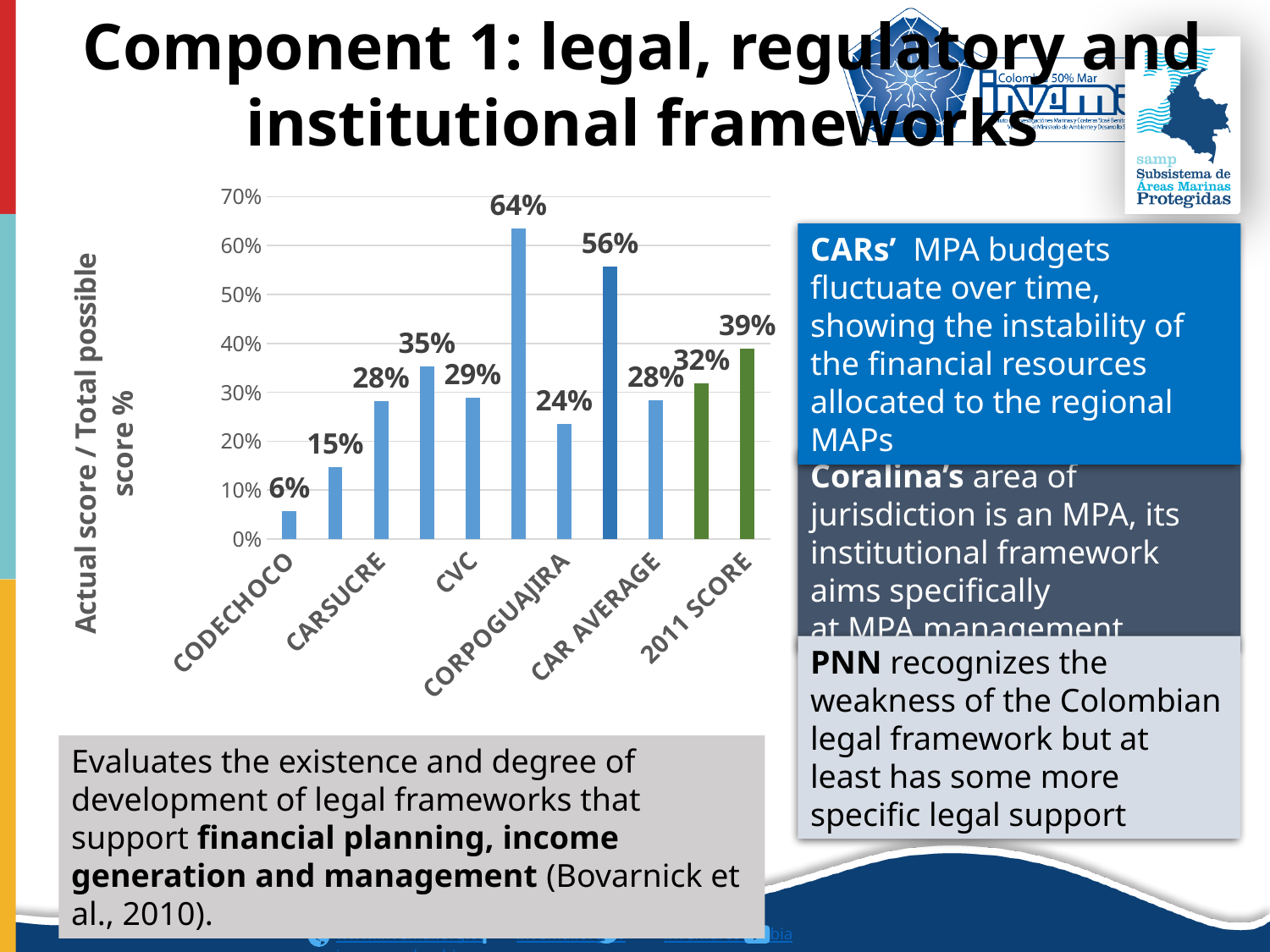
What is the value for CVC? 29% How many bars are plotted on the chart? 11 What is the value for CARSUCRE? 28% What is the value for CODECHOCO? 6% What is the difference between the 2011 SCORE and the CAR AVERAGE? 11% What is the value for 2011 SCORE? 39% What is the highest value shown on the chart? 64% Which is larger, the value for CVC or the value for CORPOGUAJIRA? CVC What is the title of the vertical axis? Actual score / Total possible score % What is the value for CAR AVERAGE? 28% Which labelled category has the lowest value? CODECHOCO What is the value for CORPOGUAJIRA? 24%